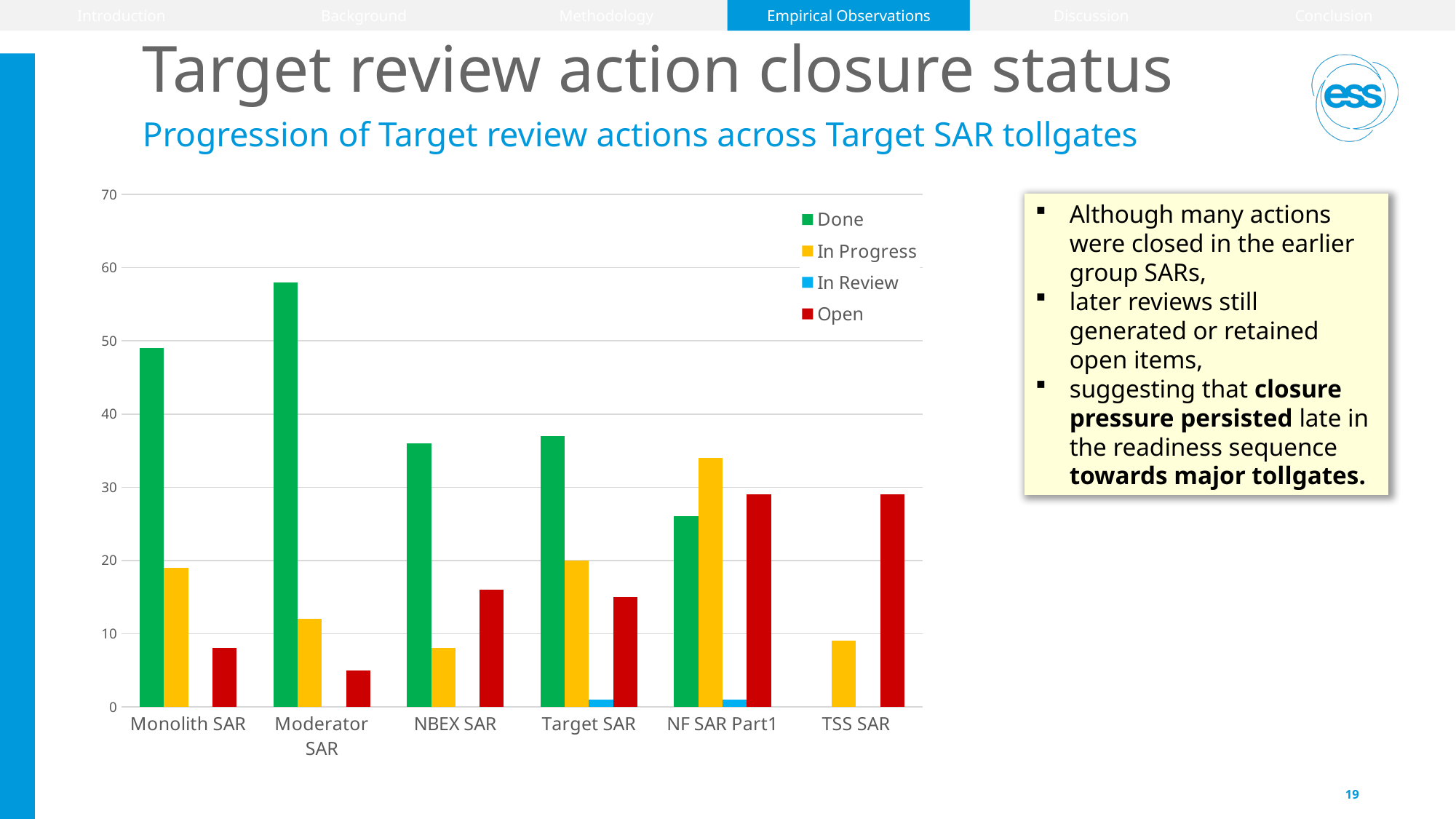
For NF SAR Part1, which is larger: the Done bar or the In Progress bar? In Progress Is the Done value for Moderator SAR greater or less than 50? greater What colour represents the Open series in the legend? Red Which category has the lowest Open bar? Moderator SAR What kind of chart is shown on the slide? Bar chart Is the Done value for Monolith SAR greater or less than 40? greater Which category has the highest In Progress bar? NF SAR Part1 How many series does the legend list? 4 Is the Open value for TSS SAR greater or less than 20? greater For NBEX SAR, which is larger: the Open bar or the In Progress bar? Open How many SAR categories are shown on the x axis? 6 Which category has the highest Done bar? Moderator SAR